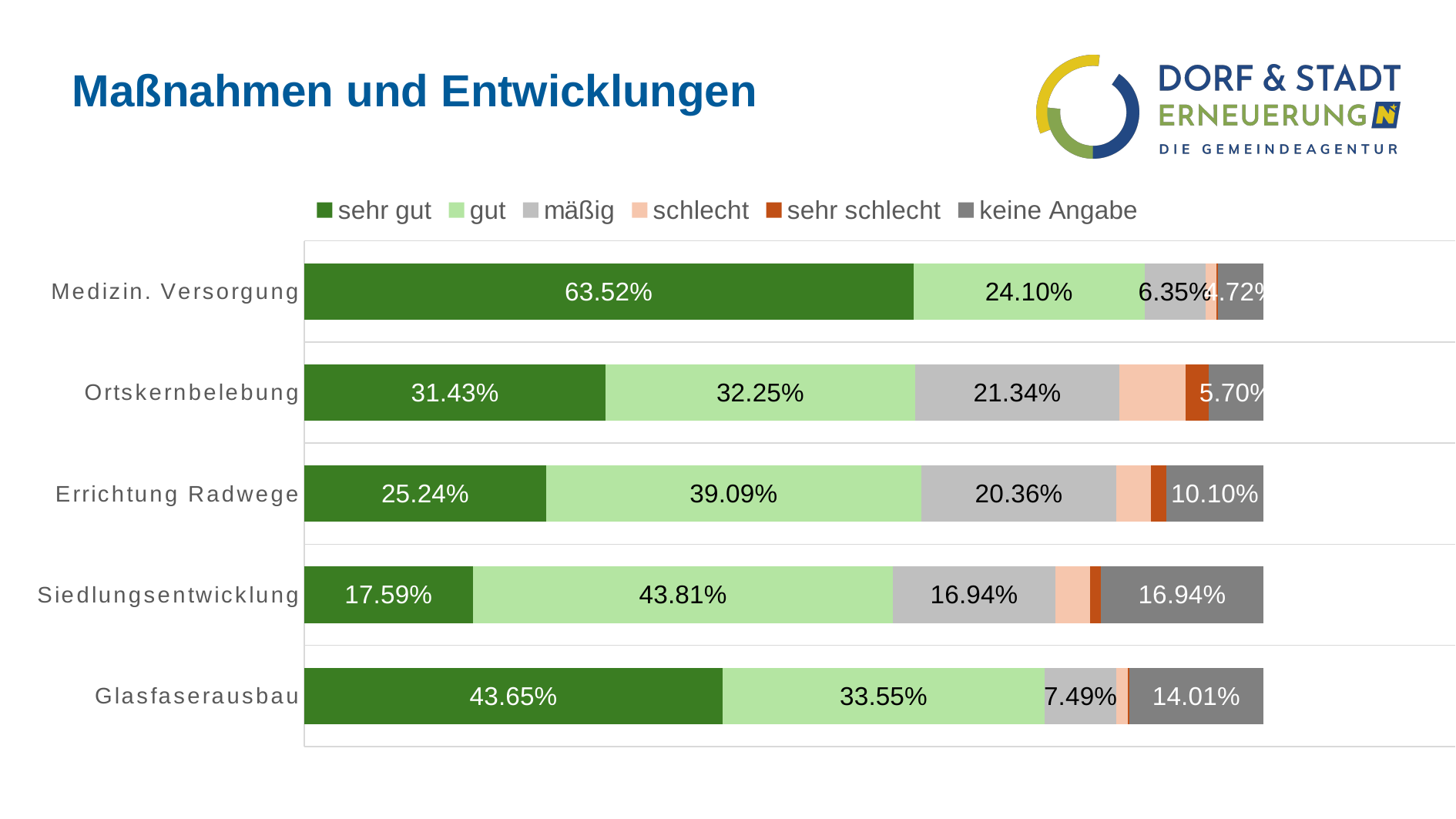
How many percentage points higher is the "sehr gut" share for Medizin. Versorgung than for Glasfaserausbau? 19.87 percentage points How many categories (measures) are shown in the chart? 5 What is the "keine Angabe" value for Glasfaserausbau? 14.01% What is the "mäßig" value for Ortskernbelebung? 21.34% Which category has the lowest "sehr gut" share? Siedlungsentwicklung What percentage of respondents rated Medizin. Versorgung as "sehr gut"? 63.52% What type of chart is shown on the slide? Stacked bar chart Which category has the highest "sehr gut" share? Medizin. Versorgung How many series does the legend list? 6 Which has the larger "gut" share: Errichtung Radwege or Ortskernbelebung? Errichtung Radwege What is the "gut" value for Siedlungsentwicklung? 43.81% What is the "keine Angabe" value for Errichtung Radwege? 10.10%